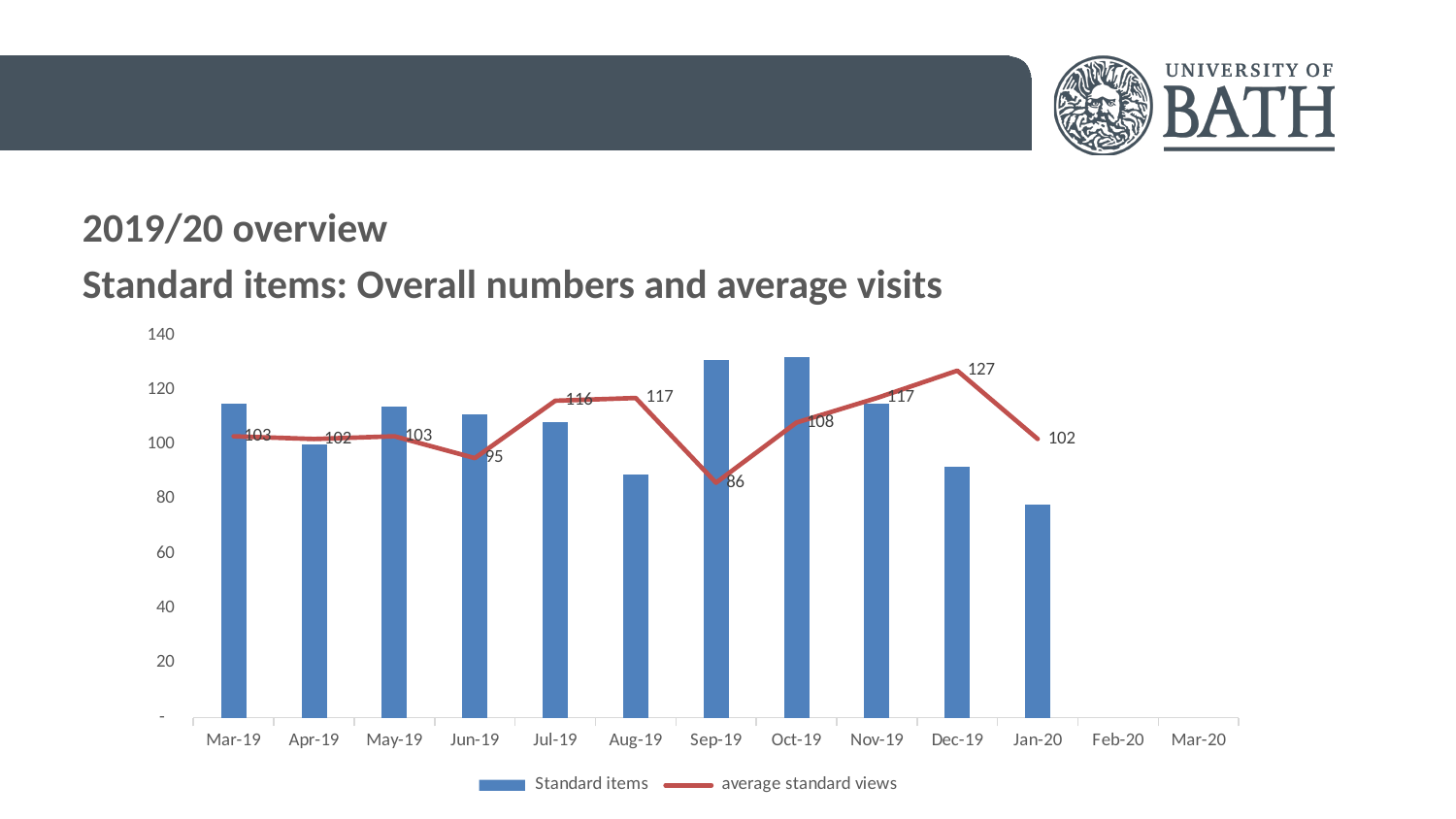
What is the average standard views value for Jun-19? 95 What is the difference between the average standard views for Dec-19 and Jan-20? 25 In which month is the average standard views line lowest? Sep-19 What is the average standard views value for Dec-19? 127 Is the Standard items bar for Aug-19 greater or less than 100? less Does the average standard views line rise or fall from Oct-19 to Dec-19? rise How many series does the legend list? 2 What is the average standard views value for Sep-19? 86 Is the Standard items bar for Sep-19 greater or less than 120? greater In which month is the average standard views line highest? Dec-19 Which has the higher average standard views, Jul-19 or Oct-19? Jul-19 Which month has the lowest Standard items bar? Jan-20